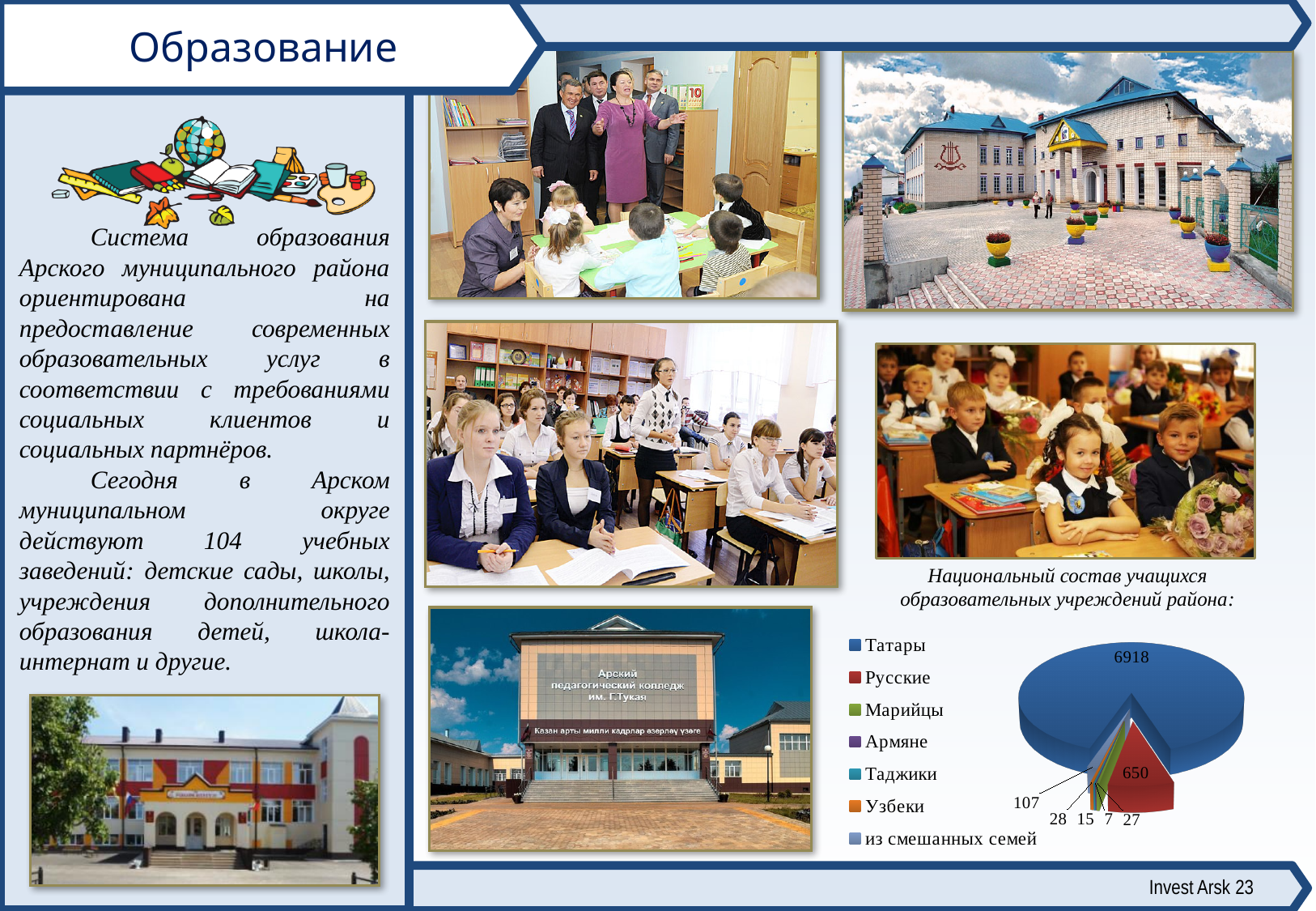
How many categories does the legend of the pie chart list? 7 What is the difference between the values for Татары and Русские in the pie chart? 6268 What colour is the slice for Татары in the pie chart? Blue What is the value shown for Татары in the pie chart? 6918 What is the title of the pie chart? Национальный состав учащихся образовательных учреждений района Which category has the largest slice in the pie chart? Татары What kind of chart is shown on the slide under the heading 'Национальный состав учащихся образовательных учреждений района'? Pie chart What is the last category listed in the pie chart's legend? из смешанных семей Which is larger in the pie chart, the value for Татары or the value for Русские? Татары What is the smallest value labelled on the pie chart? 7 What is the total of all the values labelled on the pie chart? 7752 What is the value shown for Русские in the pie chart? 650